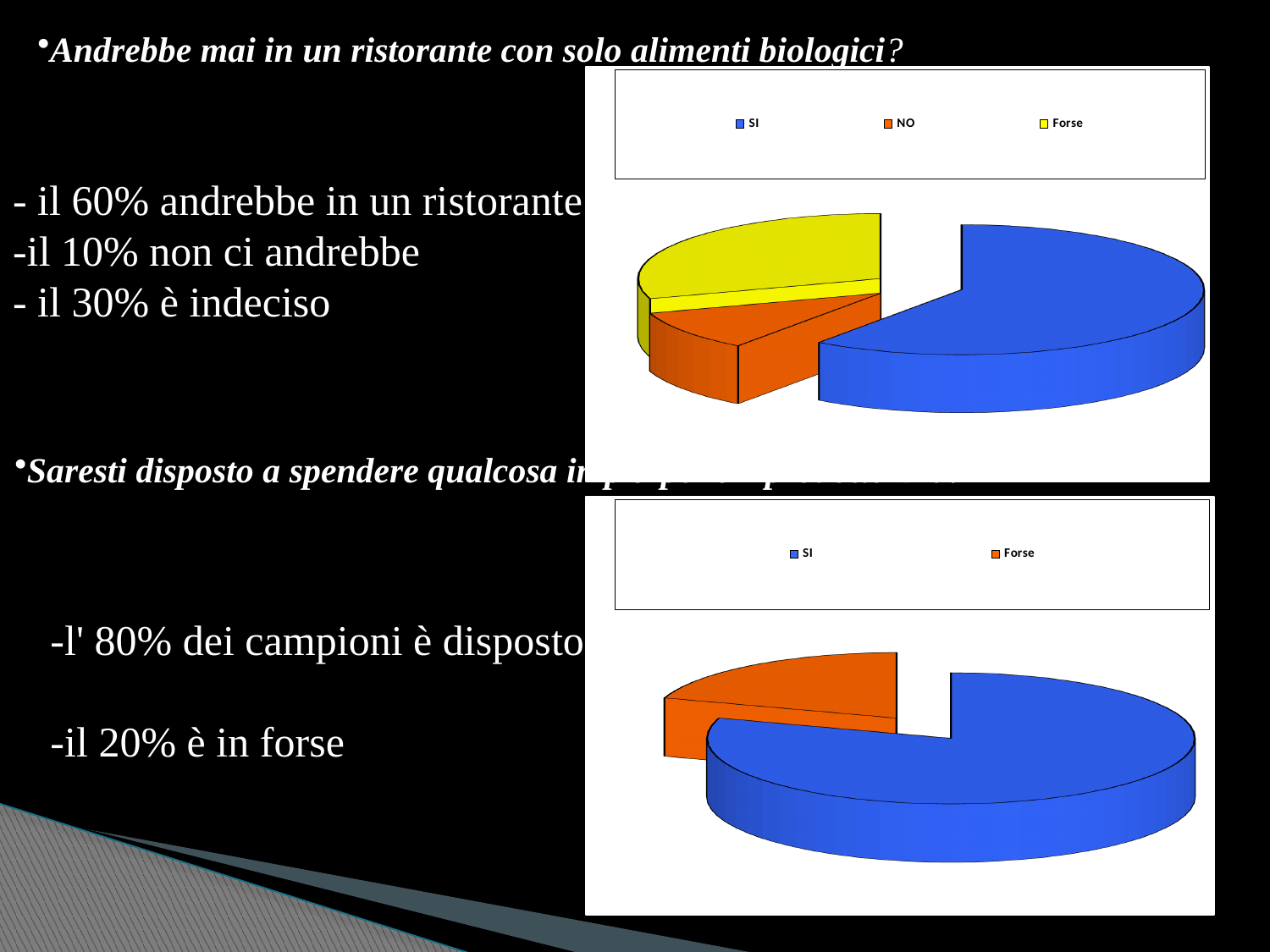
In the bottom pie chart, which category has the larger slice? SI In the top pie chart, which slice is larger, NO or Forse? Forse In the top pie chart, which category has the smallest slice? NO In the top chart, what colour is the slice for Forse? yellow How many entries does the legend of the bottom chart list? 2 How many slices does the bottom pie chart have? 2 In the bottom chart, what colour is the slice for SI? blue What kind of chart is the top chart on the slide? pie chart What kind of chart is the bottom chart on the slide? pie chart How many entries does the legend of the top chart list? 3 In the top pie chart, which category has the largest slice? SI How many slices does the top pie chart have? 3